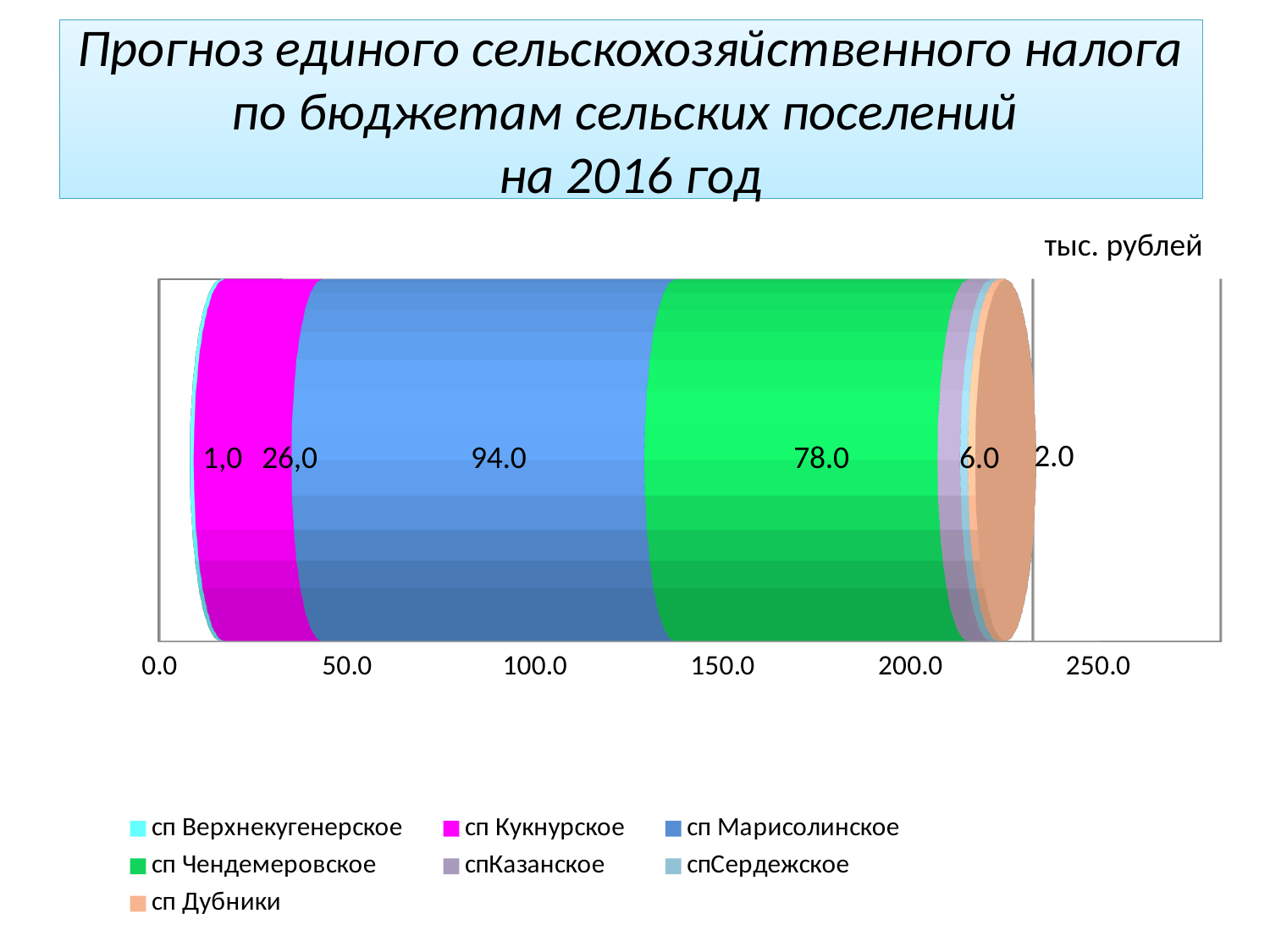
What kind of chart is shown on the slide? bar chart What is the value for сп Верхнекугенерское? 1,0 What is the value for сп Марисолинское? 94.0 What is the difference between the values for сп Кукнурское and сп Верхнекугенерское? 25,0 What is the value for сп Кукнурское? 26,0 How many series does the legend list? 7 What is the difference between the values for сп Марисолинское and сп Чендемеровское? 16.0 What is the value for сп Чендемеровское? 78.0 Is the value for сп Марисолинское greater or less than 50.0? greater Which is larger, the value for сп Марисолинское or сп Чендемеровское? сп Марисолинское What unit is indicated above the chart? тыс. рублей Which settlement has the highest forecast value? сп Марисолинское